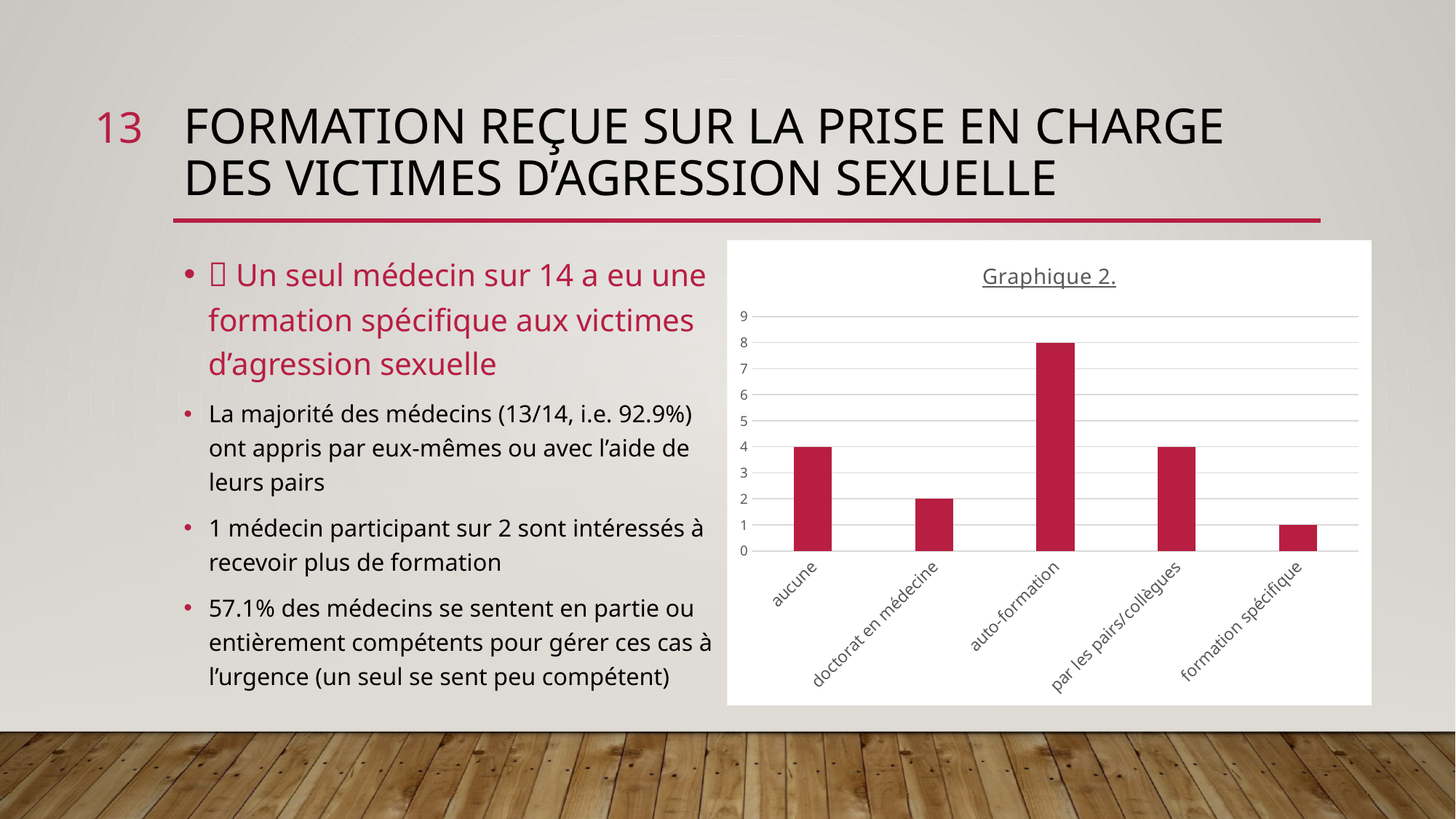
How many categories are shown on the x axis of Graphique 2.? 5 Which category has the lowest bar in Graphique 2.? formation spécifique What is the title of the chart on the slide? Graphique 2. What is the value for formation spécifique in Graphique 2.? 1 What is the value for doctorat en médecine in Graphique 2.? 2 Is the value for auto-formation in Graphique 2. greater or less than 5? greater Which category has the highest bar in Graphique 2.? auto-formation What is the value for auto-formation in Graphique 2.? 8 What is the value for aucune in Graphique 2.? 4 What kind of chart is Graphique 2.? bar chart What is the difference between the values for auto-formation and par les pairs/collègues in Graphique 2.? 4 Which is larger in Graphique 2., the value for doctorat en médecine or the value for formation spécifique? doctorat en médecine